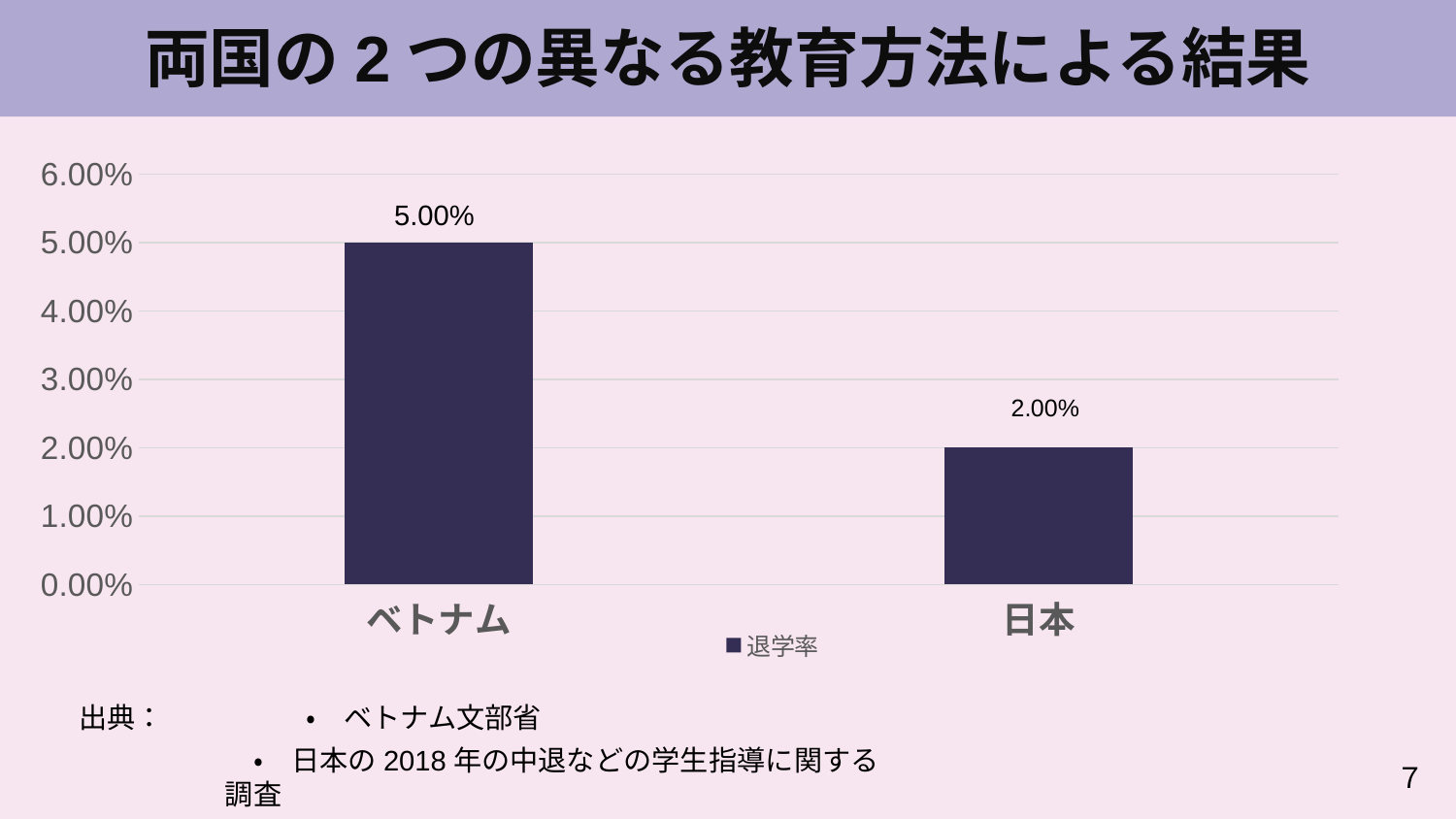
What is the highest value shown on the vertical axis? 6.00% What kind of chart is shown on the slide? Bar chart What is the difference between the dropout rates of ベトナム and 日本? 3.00% Which country has the higher dropout rate in the chart? ベトナム Which country has the lower dropout rate in the chart? 日本 How many countries (categories) are shown in the chart? 2 Is the dropout rate for 日本 greater or less than 3.00%? less What is the dropout rate (退学率) shown for 日本? 2.00% How many series does the legend list? 1 What is the name of the series shown in the legend? 退学率 What is the dropout rate (退学率) shown for ベトナム? 5.00% Is the dropout rate for ベトナム greater or less than 4.00%? greater